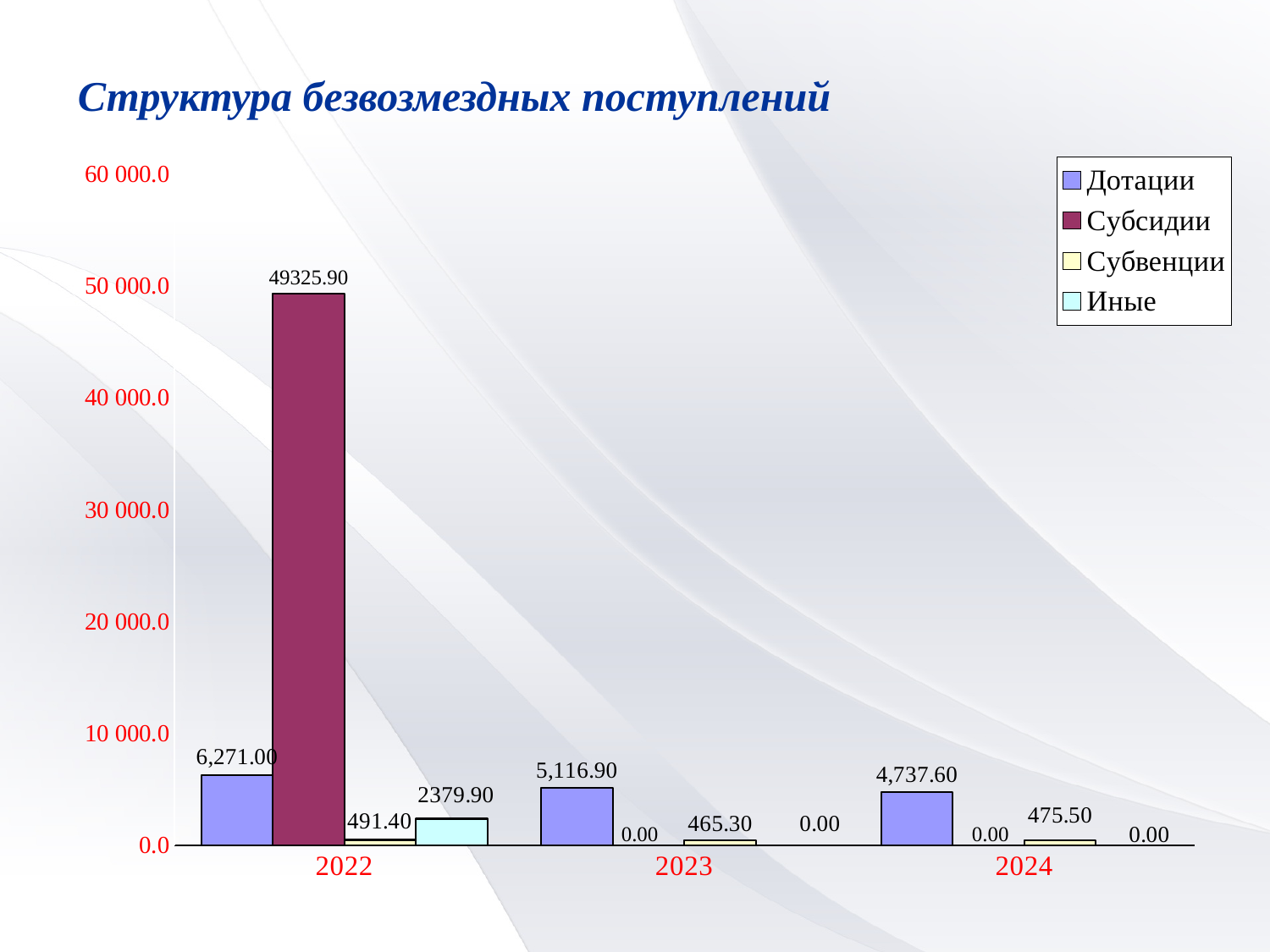
What kind of chart is shown on the slide? bar chart Which year has the lowest value for Дотации? 2024 What is the value for Дотации in 2024? 4,737.60 What is the value for Субвенции in 2023? 465.30 What is the value for Иные in 2022? 2379.90 How many series does the legend list? 4 What is the difference between the Дотации values for 2022 and 2023? 1,154.10 Which is larger in 2024: Дотации or Субвенции? Дотации What is the value for Субсидии in 2022? 49325.90 Is the value for Субсидии in 2022 greater or less than 40 000.0? greater What is the value for Дотации in 2022? 6,271.00 Which year has the highest value for Дотации? 2022